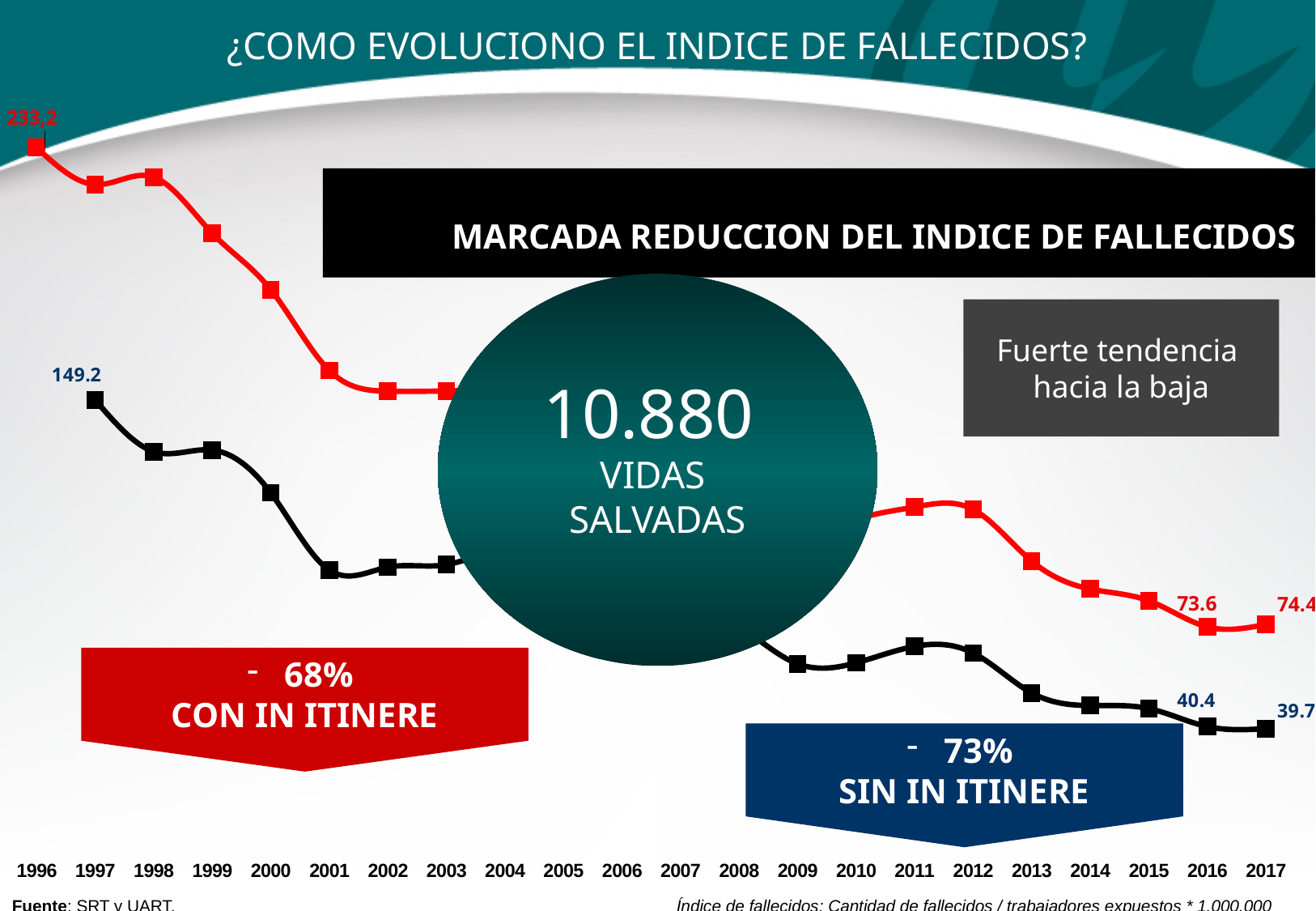
What is the value of the black line in 2016? 40.4 What type of chart is shown on the slide? line chart Which is larger in 2016, the red line value or the black line value? the red line (73.6) What is the value of the red line in 2017? 74.4 How many years are shown on the x axis? 22 What percentage reduction is shown for the series 'SIN IN ITINERE'? -73% Does the red line generally rise or fall from 1996 to 2017? fall What is the difference between the red line and the black line in 2017? 34.7 What is the value of the red line in 1996? 233,2 What is the value of the red line in 2016? 73.6 What is the value of the black line in 2017? 39.7 What is the value of the black line in 1997? 149.2